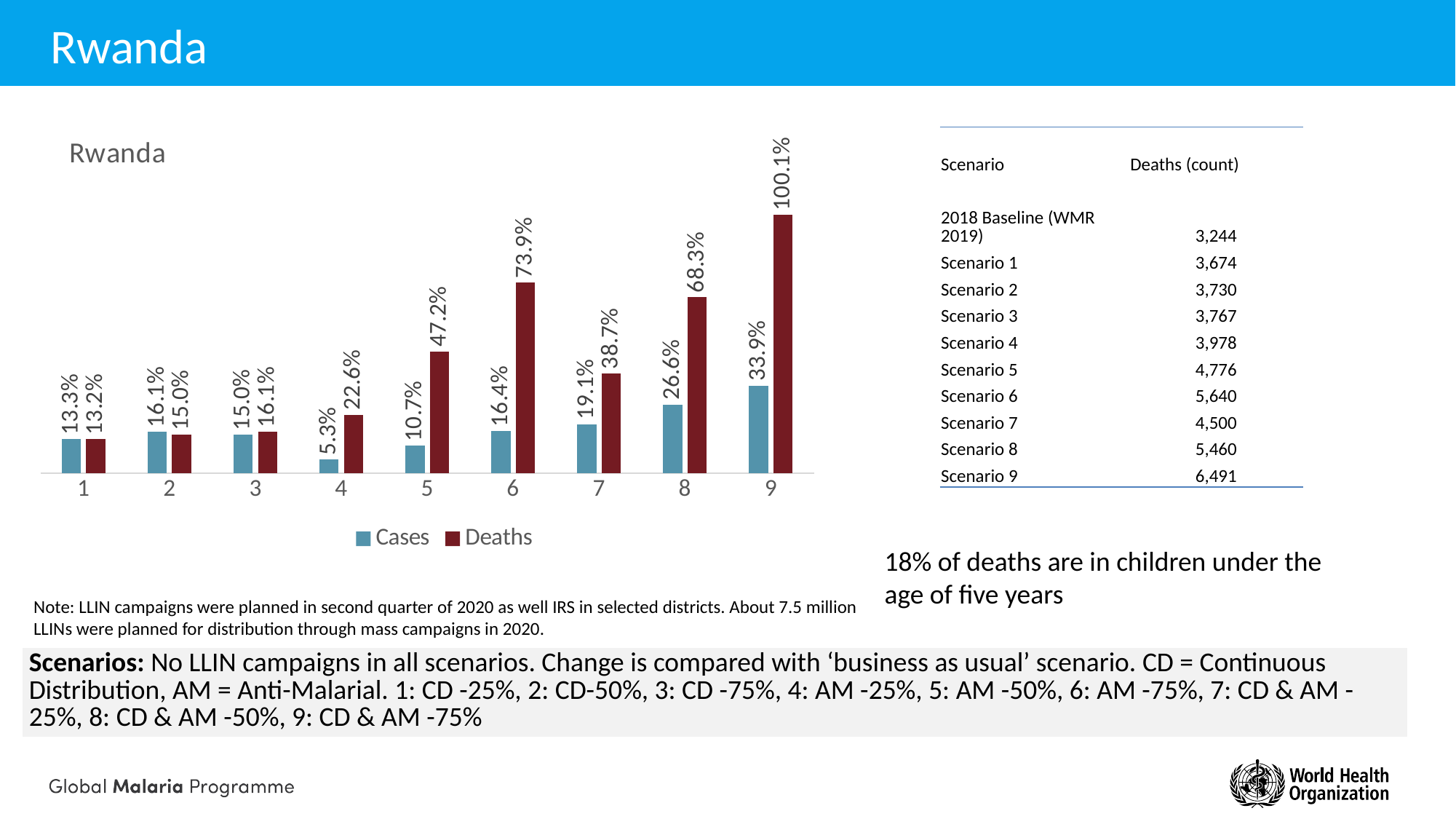
What kind of chart is shown on the slide? Bar chart What is the Deaths value for scenario 6? 73.9% Which is larger for scenario 5, the Cases value or the Deaths value? Deaths What are the two series named in the chart legend? Cases and Deaths What is the Cases value for scenario 9? 33.9% How many scenarios are shown on the x axis of the chart? 9 Which scenario has the lowest Cases value? 4 What is the difference between the Deaths and Cases values for scenario 9? 66.2% What is the Cases value for scenario 4? 5.3% How many series does the chart legend list? 2 What is the difference between the Deaths values for scenario 6 and scenario 7? 35.2% Which scenario has the highest Deaths value? 9